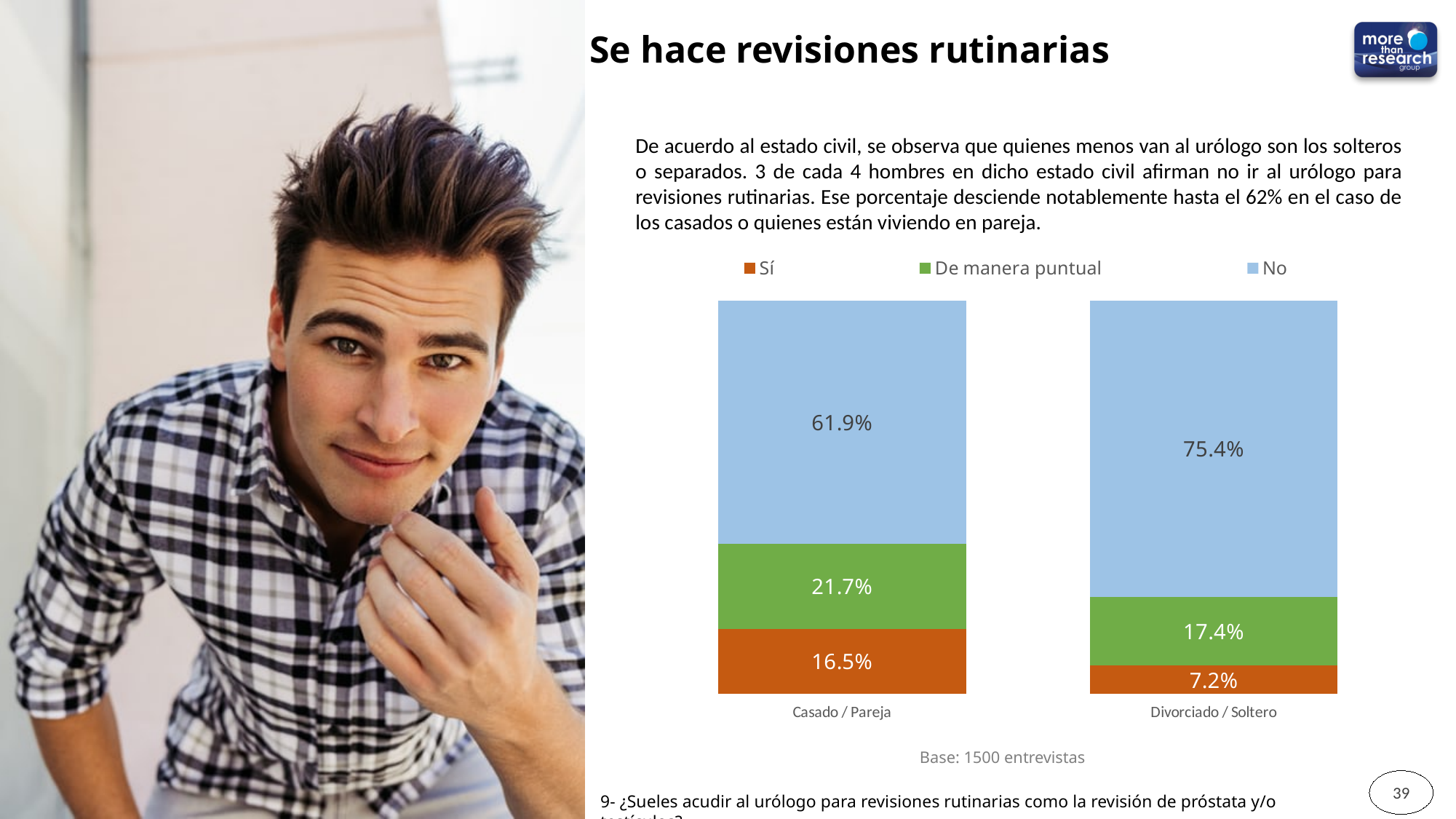
What is the value for "No" in the Casado / Pareja bar? 61.9% Which legend entry is shown in orange? Sí Which category has the higher value for "Sí"? Casado / Pareja What kind of chart is shown on the slide? Stacked bar chart Which category has the lower value for "De manera puntual"? Divorciado / Soltero What is the difference between the "No" values for Divorciado / Soltero and Casado / Pareja? 13.5% Is the "Sí" value larger for Casado / Pareja or for Divorciado / Soltero? Casado / Pareja What is the value for "Sí" in the Divorciado / Soltero bar? 7.2% What is the value for "De manera puntual" in the Casado / Pareja bar? 21.7% What is the value for "No" in the Divorciado / Soltero bar? 75.4% How many categories are shown on the x axis? 2 How many series does the legend list? 3